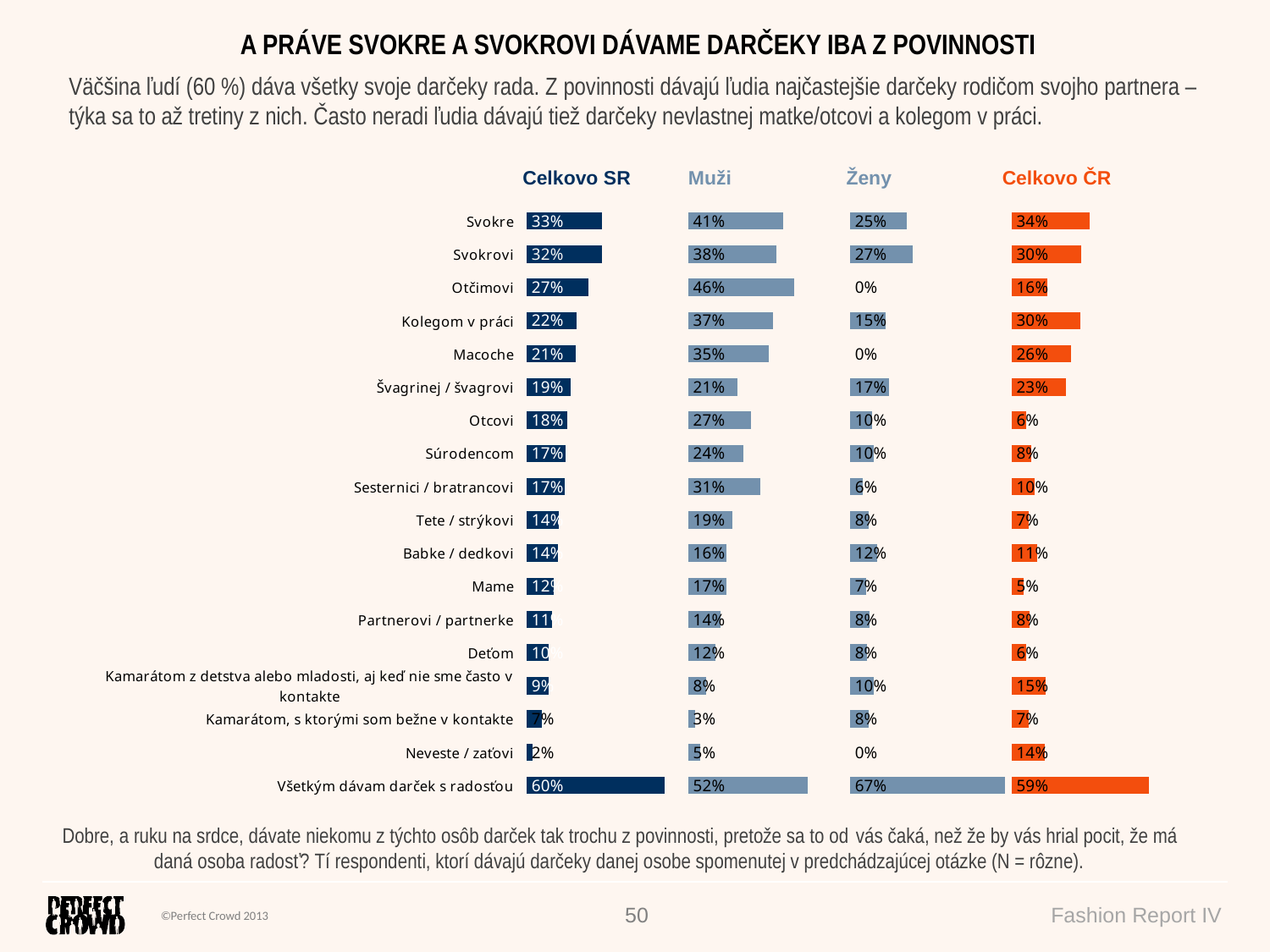
What type of chart is used for the Celkovo ČR data? Bar chart In the Celkovo SR chart, what is the value for Svokre? 33% In the Celkovo ČR chart, what is the value for Neveste / zaťovi? 14% Which is larger: the value for Kolegom v práci in the Muži chart or in the Ženy chart? Muži In the Celkovo SR chart, which category has the lowest value? Neveste / zaťovi How many categories are shown in the Celkovo SR chart? 18 What colour are the bars in the Celkovo ČR chart? Orange In the Ženy chart, what is the value for Všetkým dávam darček s radosťou? 67% In the Celkovo ČR chart, what is the difference between the values for Svokre and Otčimovi? 18% In the Muži chart, what is the value for Otčimovi? 46% In the Muži chart, which category has the highest value? Všetkým dávam darček s radosťou In the Muži chart, what is the difference between the values for Svokre and Svokrovi? 3%